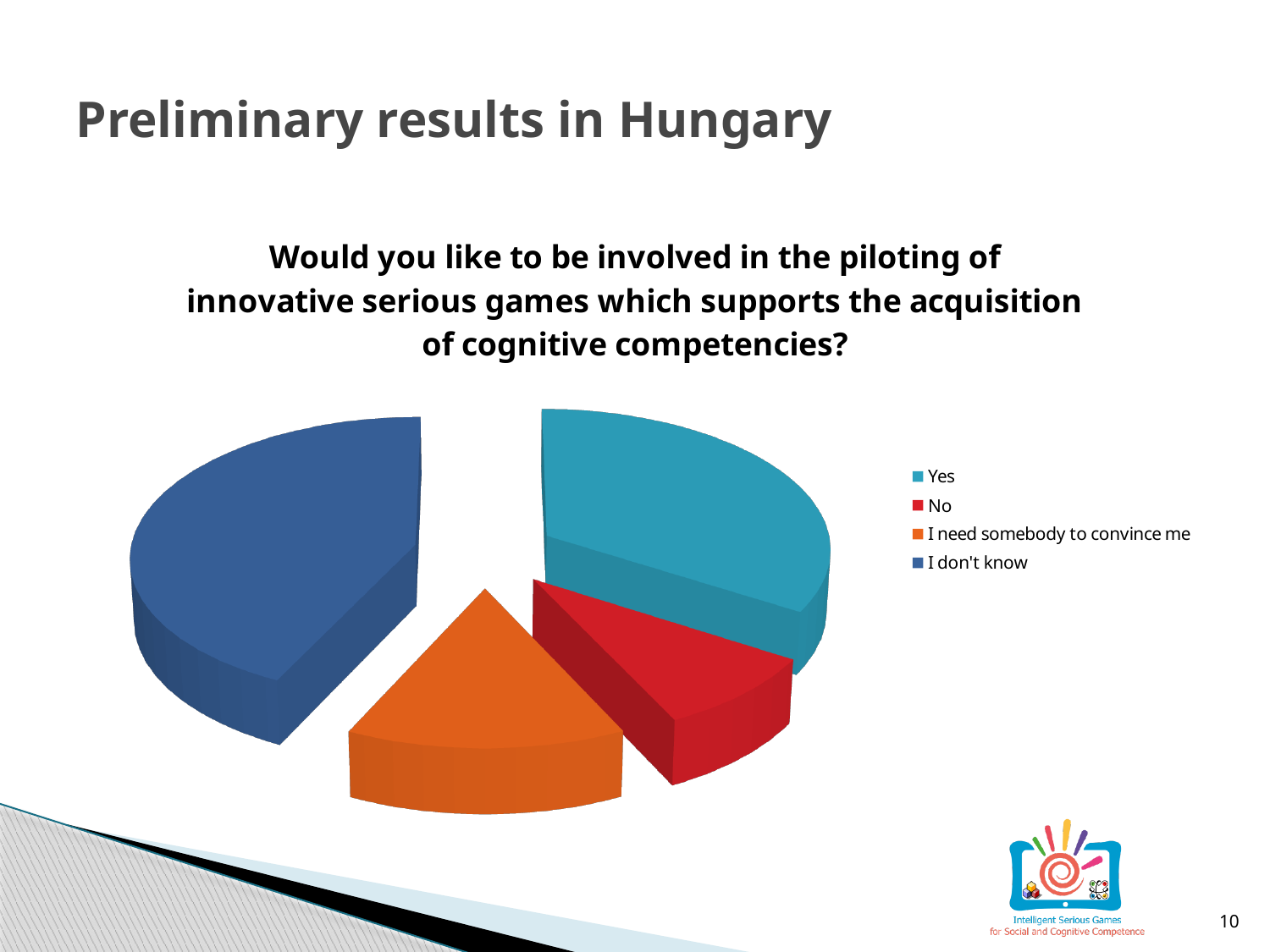
Which category has the largest slice in the pie chart? I don't know What question does the pie chart's title ask? Would you like to be involved in the piloting of innovative serious games which supports the acquisition of cognitive competencies? Which legend entry is shown in red in the pie chart? No Which slice is larger, "Yes" or "No"? Yes How many entries does the legend of the pie chart list? 4 What kind of chart is shown on the slide? Pie chart Which slice is larger, "Yes" or "I need somebody to convince me"? Yes How many categories does the pie chart show? 4 Which slice is larger, "I don't know" or "I need somebody to convince me"? I don't know